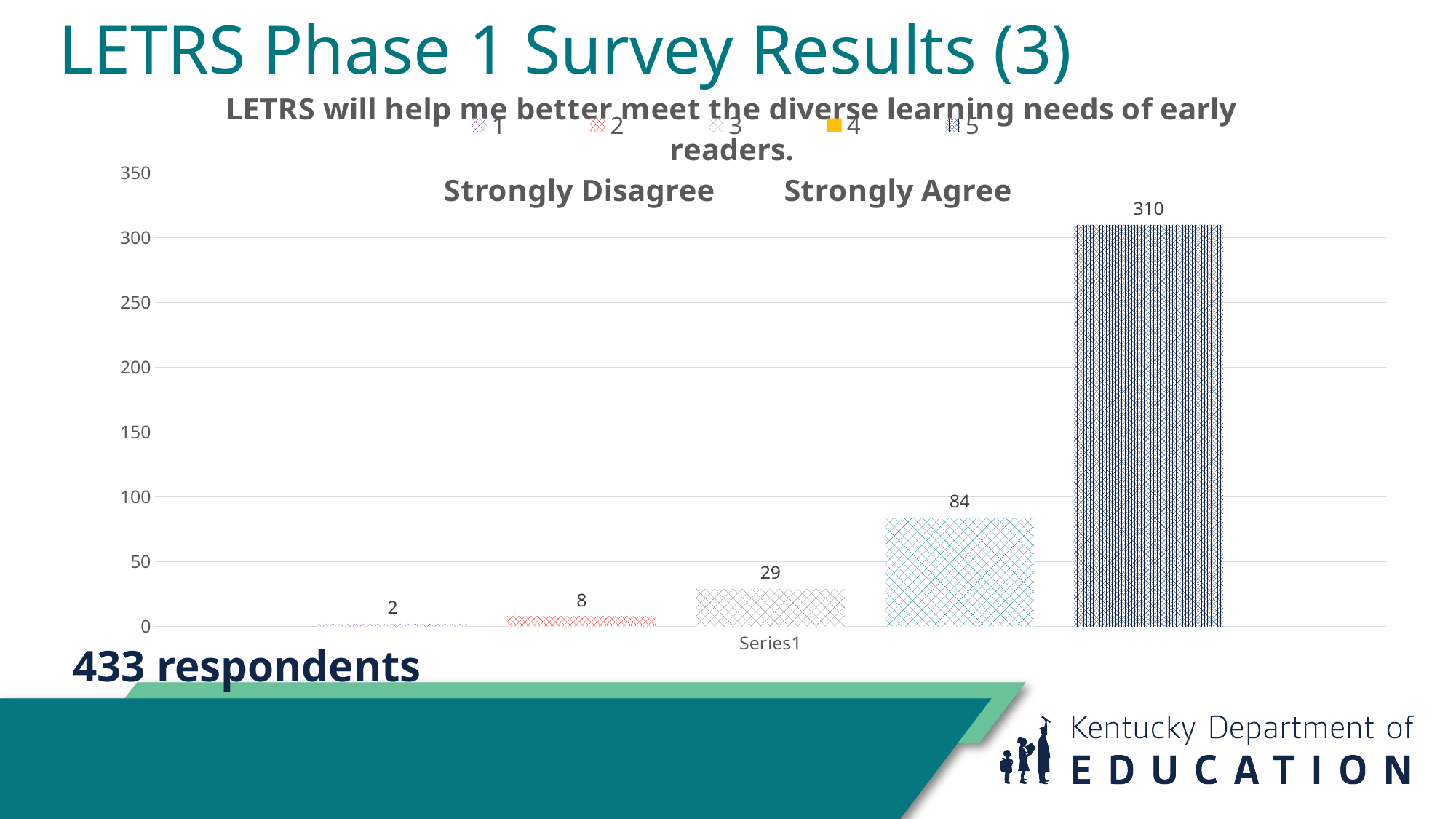
What value is shown for rating 4? 84 How many series does the legend list? 5 What value is shown for rating 5 (Strongly Agree)? 310 What kind of chart is shown on the slide? bar chart Which rating has the highest number of respondents? 5 Is the value for rating 5 greater or less than 300? greater What is the difference between the values for rating 3 and rating 2? 21 What value is shown for rating 3? 29 Which rating has the lowest number of respondents? 1 Which is larger, the value for rating 2 or the value for rating 3? rating 3 What value is shown for rating 1 (Strongly Disagree)? 2 What is the difference between the values for rating 5 and rating 4? 226